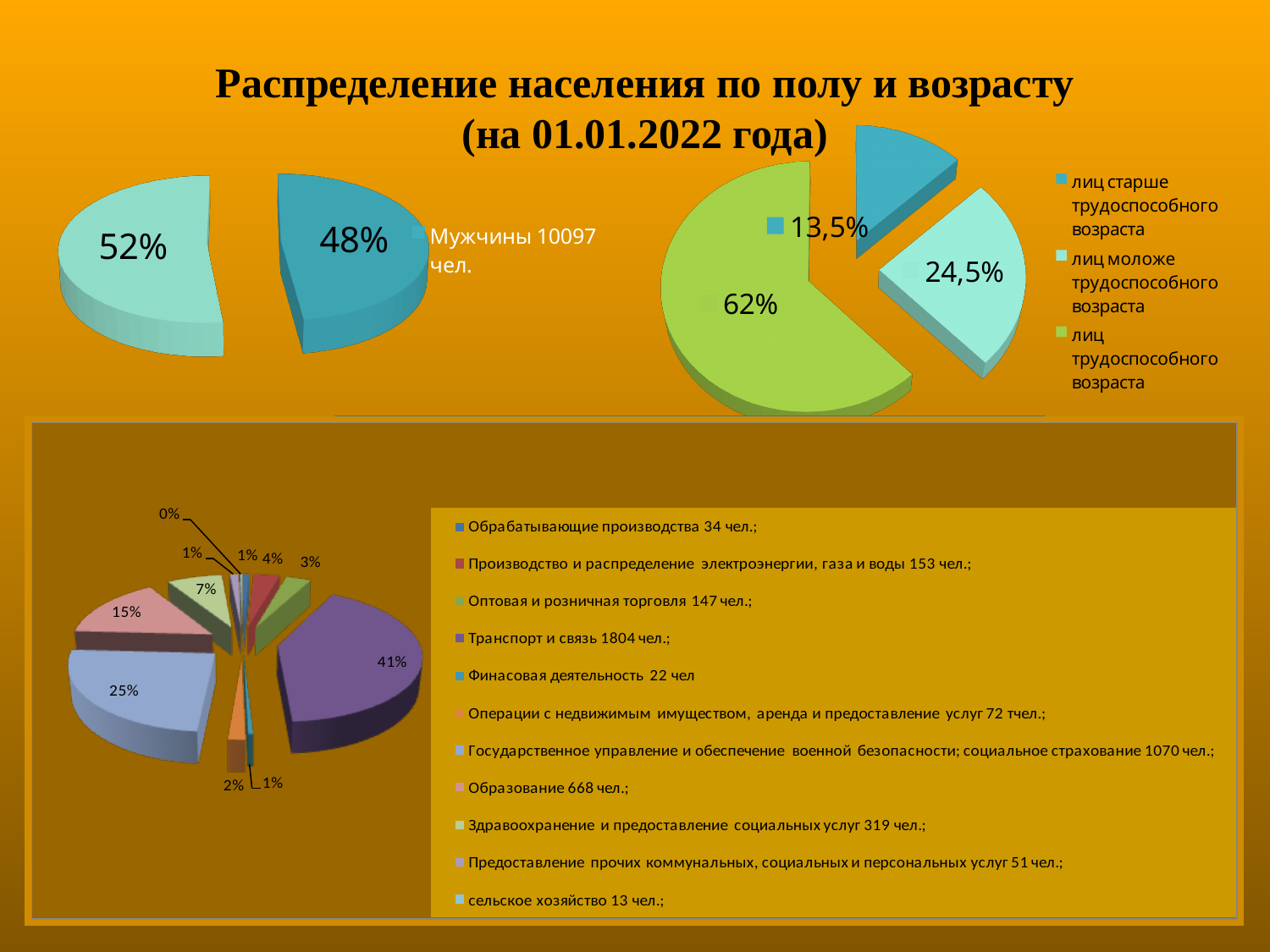
In the top-right pie chart, what share is shown for 'лиц старше трудоспособного возраста'? 13,5% In the top-left pie chart, what percentage is shown for the larger slice? 52% What type of charts are shown on the slide? Pie charts In the top-right pie chart, what share is shown for 'лиц трудоспособного возраста'? 62% In the top-right pie chart, which category has the smallest share? лиц старше трудоспособного возраста In the bottom pie chart, what is the difference in people between 'Транспорт и связь' (1804 чел.) and 'Государственное управление и обеспечение военной безопасности; социальное страхование' (1070 чел.)? 734 In the bottom pie chart, what is the share of the largest slice? 41% In the top-left pie chart, what percentage corresponds to the slice labelled 'Мужчины 10097 чел.'? 48% How many categories does the legend of the top-right pie chart list? 3 In the bottom pie chart, how many categories does the legend list? 11 In the bottom pie chart, which category has the largest share? Транспорт и связь 1804 чел.